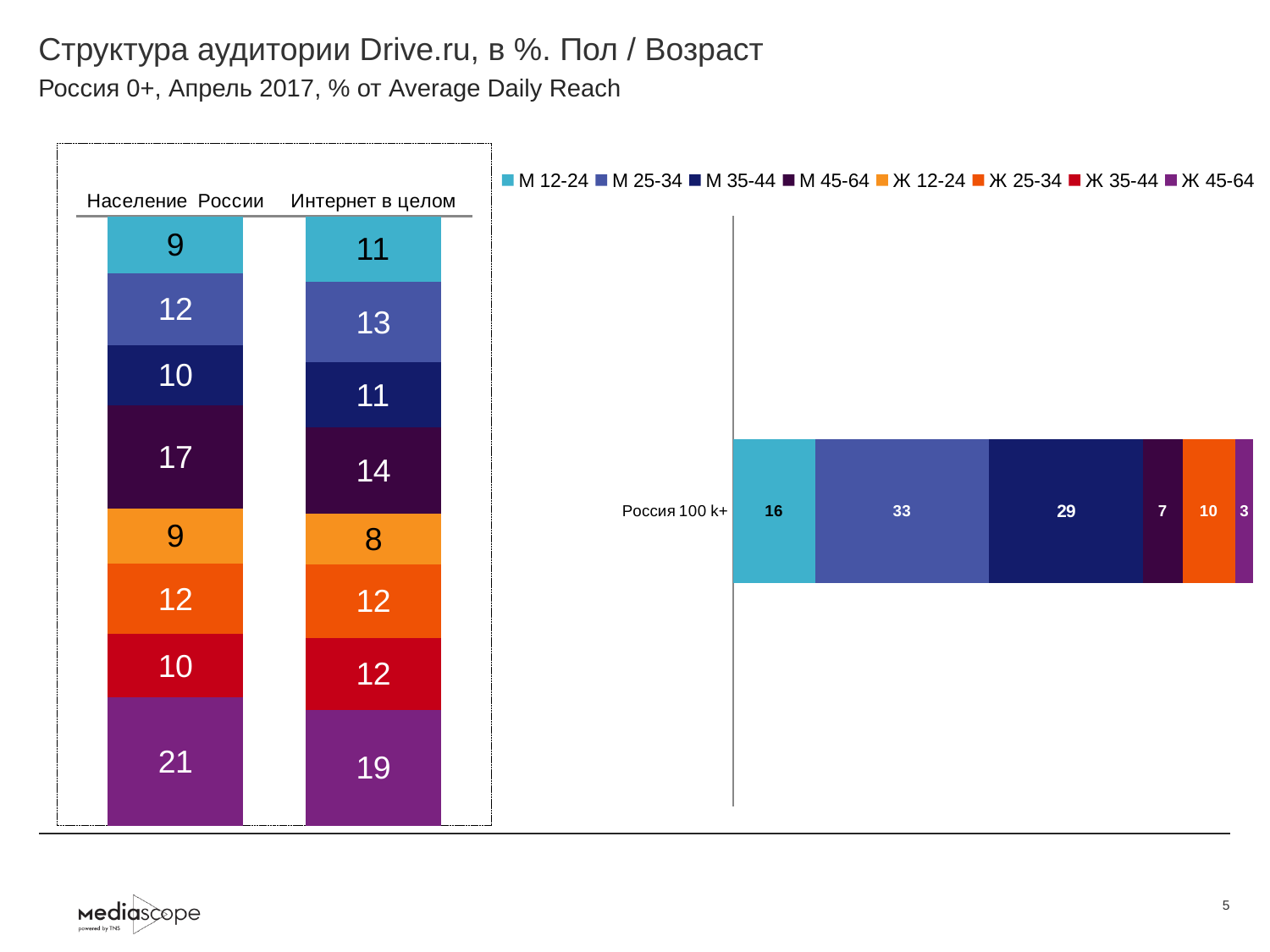
How many series does the legend on the right chart list? 8 In the left chart, which segment is the largest in the Население России bar? Ж 45-64 In the left chart, what is the difference between Ж 45-64 in Население России and Ж 45-64 in Интернет в целом? 2 What kind of chart is the right chart (Россия 100 k+)? Stacked bar chart In the right chart (Россия 100 k+), what is the value for М 35-44? 29 In the right chart (Россия 100 k+), which series has the largest segment? М 25-34 In the left chart, what is the value for М 45-64 in the Интернет в целом bar? 14 In the left chart, what is the value for М 12-24 in the Население России bar? 9 In the right chart (Россия 100 k+), what is the value for М 25-34? 33 In the left chart, what is the total of the Интернет в целом stacked bar? 100 In the left chart, what is the value for Ж 45-64 in the Население России bar? 21 In the left chart, which is larger: М 45-64 in Население России or М 45-64 in Интернет в целом? Население России